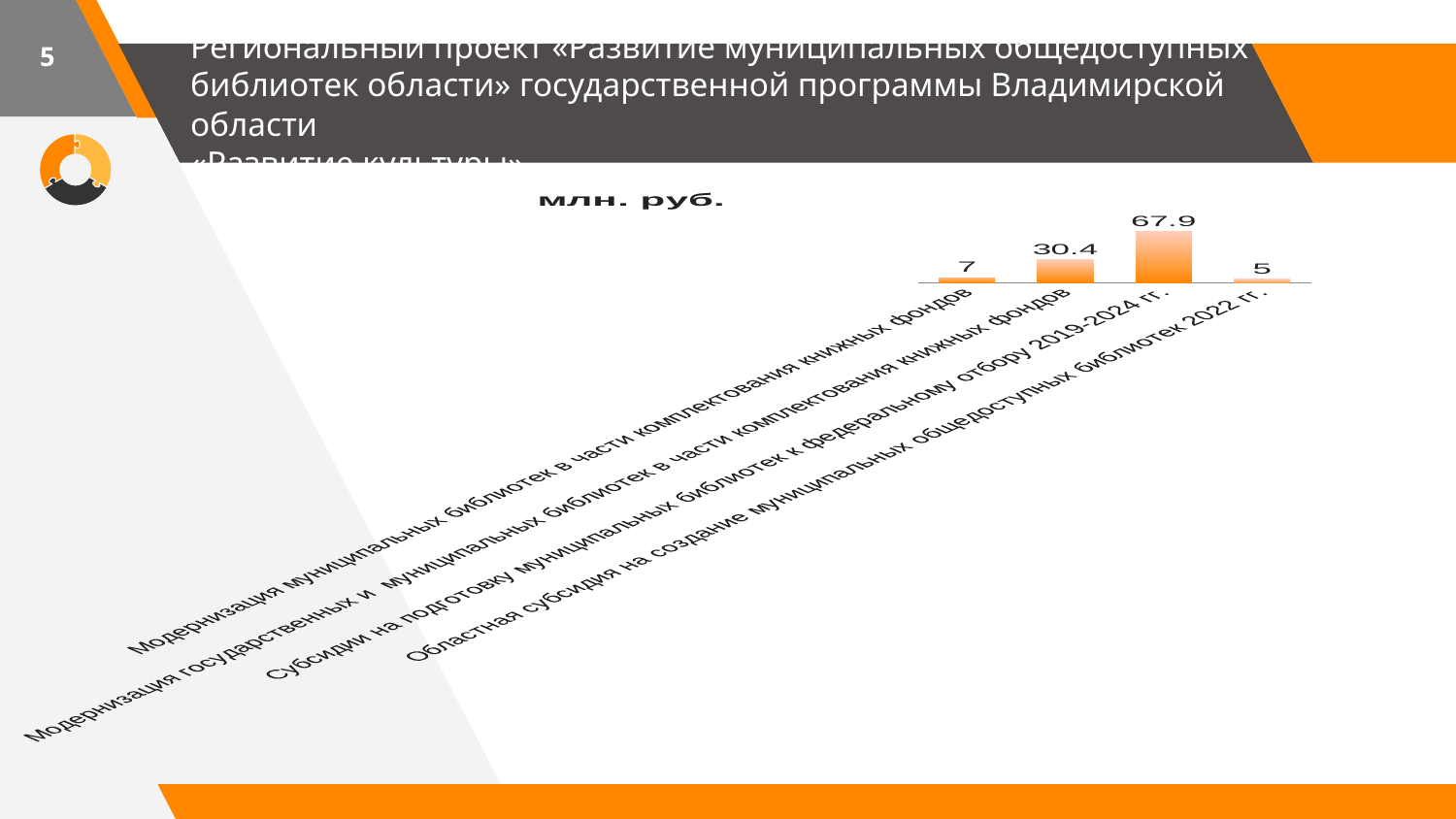
What is the value for «Областная субсидия на создание муниципальных общедоступных библиотек 2022 гг.»? 5 What is the value for «Субсидии на подготовку муниципальных библиотек к федеральному отбору 2019-2024 гг.»? 67.9 Which category has the lowest value? Областная субсидия на создание муниципальных общедоступных библиотек 2022 гг. Which is larger: the value for «Модернизация муниципальных библиотек в части комплектования книжных фондов» or for «Областная субсидия на создание муниципальных общедоступных библиотек 2022 гг.»? Модернизация муниципальных библиотек в части комплектования книжных фондов Which category has the highest value? Субсидии на подготовку муниципальных библиотек к федеральному отбору 2019-2024 гг. What is the difference between the values for «Субсидии на подготовку муниципальных библиотек к федеральному отбору 2019-2024 гг.» and «Модернизация государственных и муниципальных библиотек в части комплектования книжных фондов»? 37.5 What type of chart is shown on the slide? bar chart What is the title of the chart? млн. руб. What is the value for «Модернизация муниципальных библиотек в части комплектования книжных фондов»? 7 What is the value for «Модернизация государственных и муниципальных библиотек в части комплектования книжных фондов»? 30.4 What is the difference between the values for «Модернизация муниципальных библиотек в части комплектования книжных фондов» and «Областная субсидия на создание муниципальных общедоступных библиотек 2022 гг.»? 2 How many bars (categories) does the chart show? 4